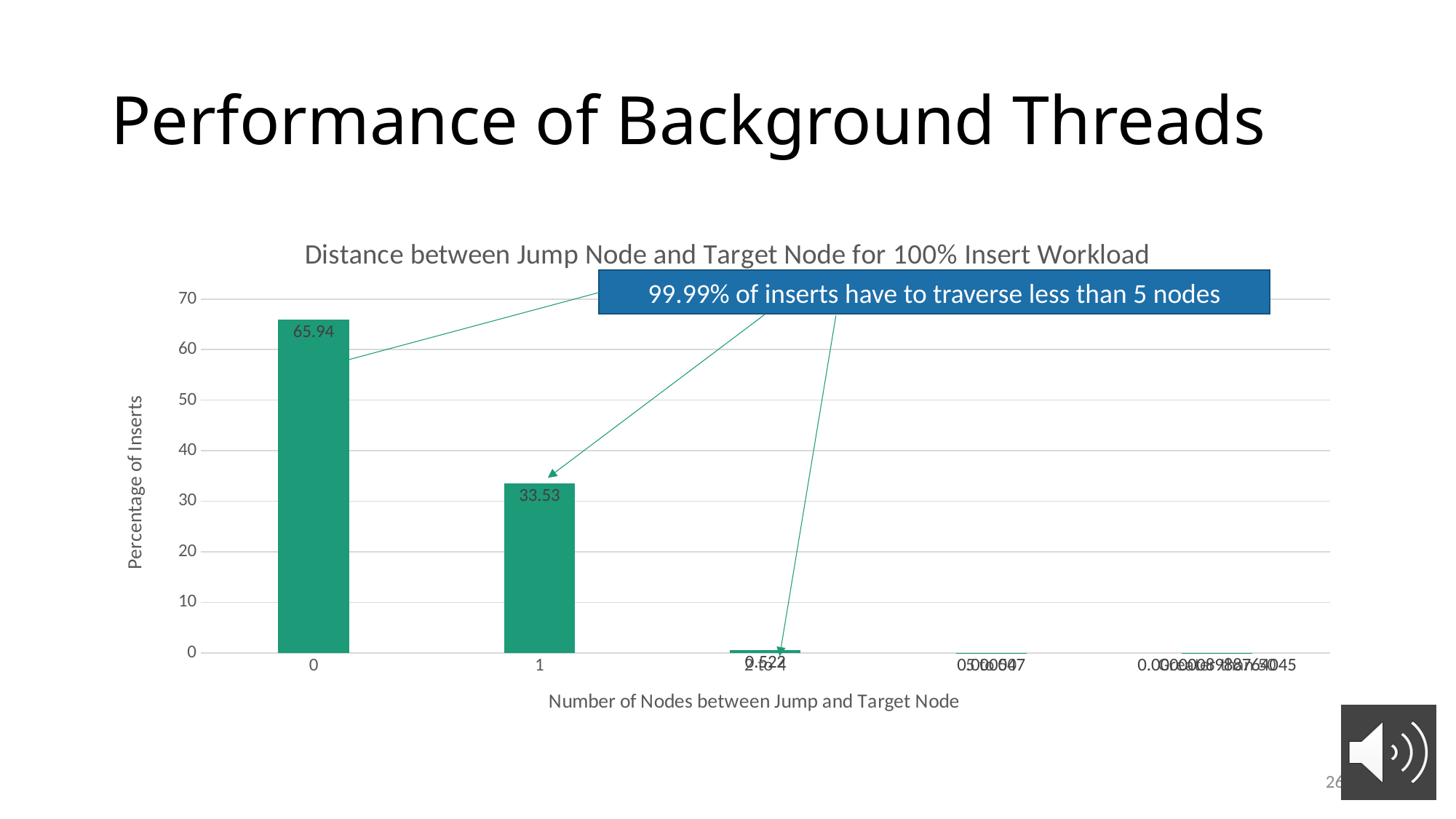
Which is larger, the percentage of inserts for 0 nodes or for 1 node? 0 nodes Is the value for 0 nodes greater or less than 60? greater Is the value for 1 node greater or less than 40? less What is the percentage of inserts for 1 node between jump and target node? 33.53 What kind of chart is shown on the slide? bar chart What is the title of the chart? Distance between Jump Node and Target Node for 100% Insert Workload What is the difference between the percentage of inserts for 0 nodes and for 1 node? 32.41 What is the label of the y axis? Percentage of Inserts Do the values rise or fall as the number of nodes increases along the x axis? fall What is the percentage of inserts for 0 nodes between jump and target node? 65.94 How many categories are plotted along the x axis? 5 Which category has the highest percentage of inserts? 0